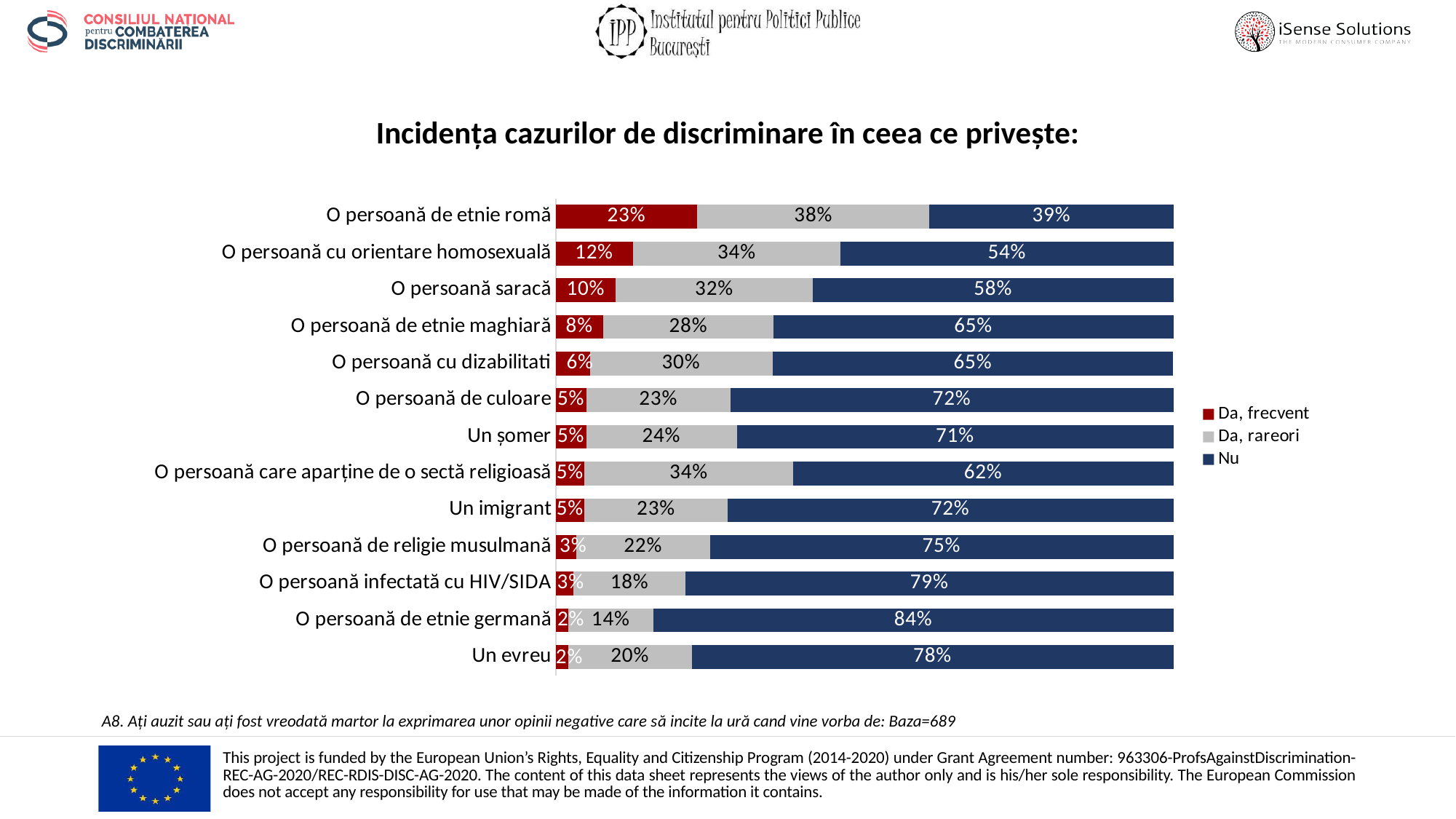
What is the 'Nu' value for 'O persoană infectată cu HIV/SIDA'? 79% What is the total of the stacked bar for 'O persoană de etnie maghiară'? 101% What is the 'Da, frecvent' value for 'O persoană de etnie romă'? 23% What type of chart is shown on the slide? stacked bar chart Which is larger: the 'Da, rareori' value for 'O persoană saracă' or for 'O persoană de etnie maghiară'? O persoană saracă How many series does the legend list? 3 Which category has the lowest 'Nu' value? O persoană de etnie romă What is the 'Da, rareori' value for 'O persoană care aparține de o sectă religioasă'? 34% Which legend entry is shown in dark red? Da, frecvent What is the difference between the 'Nu' values for 'O persoană de etnie germană' and 'Un evreu'? 6% How many categories are plotted on the chart? 13 Which category has the highest 'Nu' value? O persoană de etnie germană